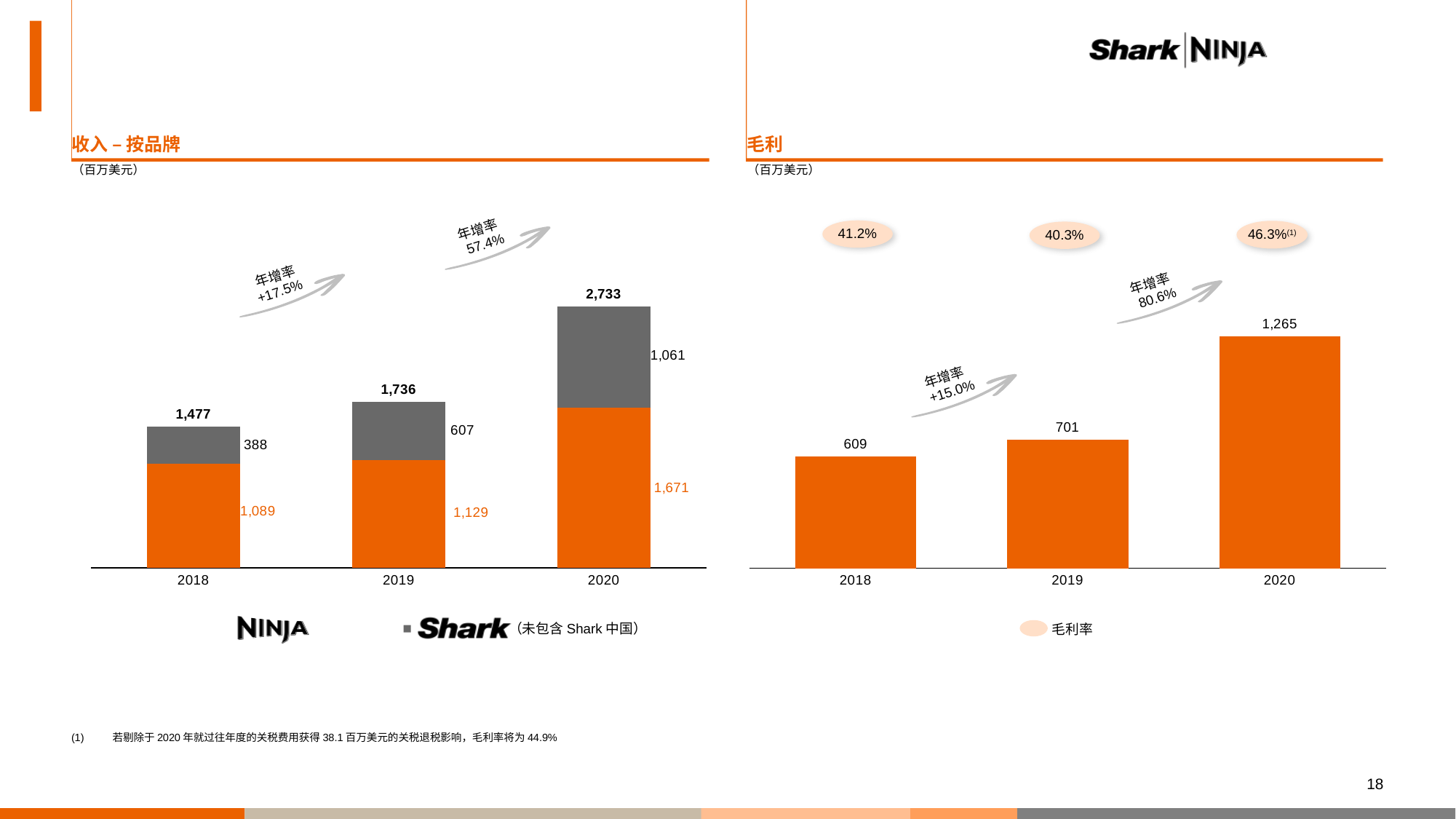
In the 收入 – 按品牌 chart on the left, which year has the highest total revenue? 2020 In the 收入 – 按品牌 chart on the left, what is the total revenue for 2020? 2,733 In the 毛利 chart on the right, what is the difference in gross profit between 2020 and 2018? 656 What kind of chart is the 毛利 chart on the right? Bar chart In the 收入 – 按品牌 chart on the left, what is the year-over-year growth rate shown between 2019 and 2020? 57.4% In the 收入 – 按品牌 chart on the left, what is the Ninja revenue for 2019? 1,129 In the 收入 – 按品牌 chart on the left, what is the Shark revenue for 2018? 388 In the 毛利 chart on the right, what is the gross profit for 2019? 701 In the 收入 – 按品牌 chart on the left, what is the difference between the Ninja and Shark revenue in 2020? 610 In the 毛利 chart on the right, which year has the lowest gross profit? 2018 In the 收入 – 按品牌 chart on the left, how many brands does the legend list? 2 In the 毛利 chart on the right, what is the gross margin (毛利率) shown for 2020? 46.3%